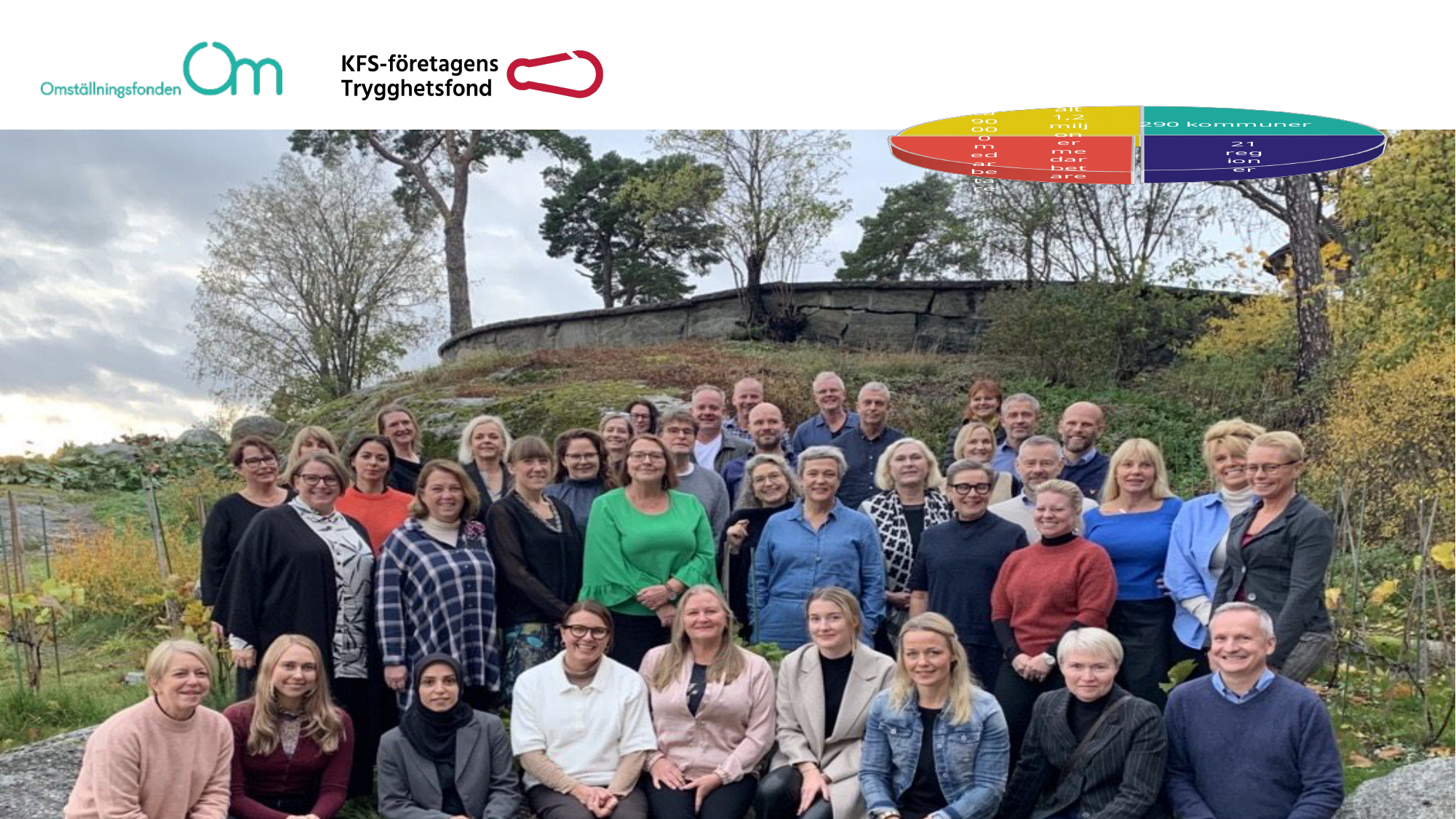
According to the pie chart, how many kommuner are there? 290 In the pie chart, what label is shown on the teal slice? 290 kommuner In the pie chart, what label is shown on the purple slice? 21 regioner How many slices does the pie chart in the top right corner have? 4 What kind of chart is shown in the top right corner of the slide? pie chart According to the pie chart, how many regioner are there? 21